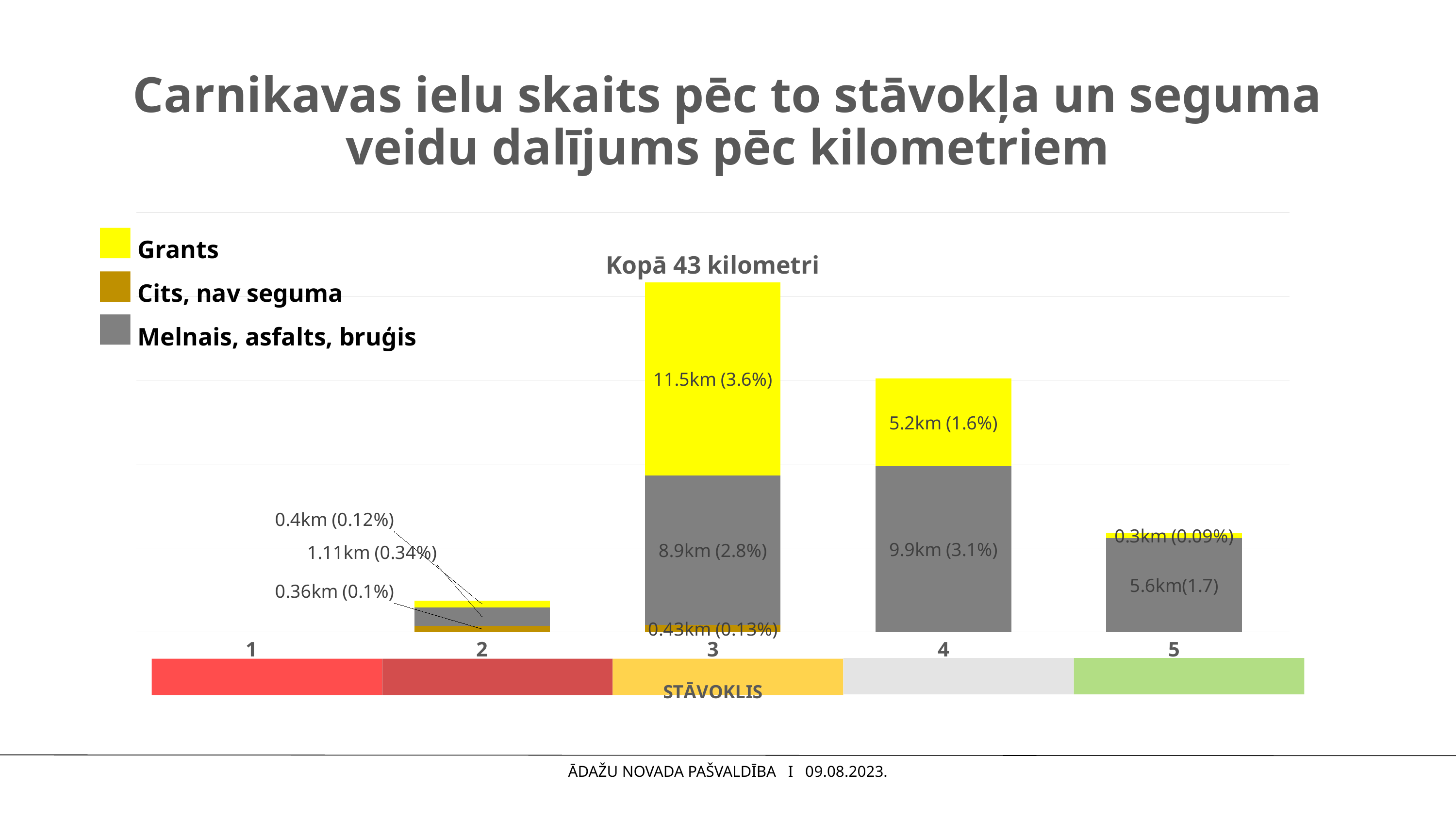
What is the value of Melnais, asfalts, bruģis for category 2? 1.11km (0.34%) How many categories are shown on the x axis? 5 What total length in kilometres is stated above the chart? Kopā 43 kilometri What is the value of Grants for category 5? 0.3km (0.09%) What is the difference in kilometres between the Melnais, asfalts, bruģis values for category 4 and category 3? 1km What is the value of Grants for category 3? 11.5km (3.6%) What is the value of Melnais, asfalts, bruģis for category 4? 9.9km (3.1%) What kind of chart is shown on the slide? stacked bar chart What is the value of Cits, nav seguma for category 3? 0.43km (0.13%) Which category has the tallest stacked bar? 3 How many series does the legend list? 3 Which is larger, the Grants value for category 3 or for category 4? category 3